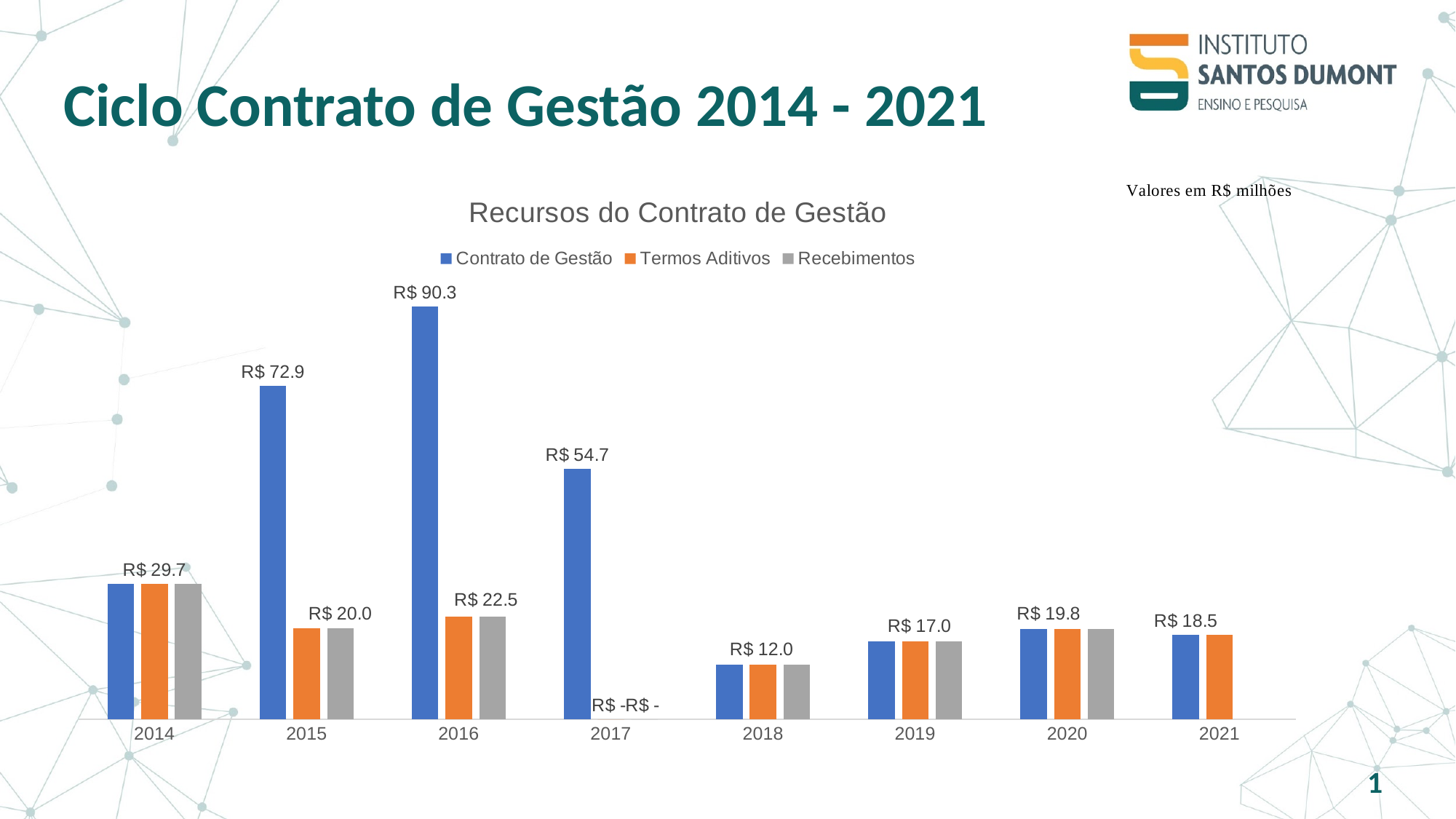
How many series does the legend list? 3 What kind of chart is shown? Bar chart What is the value of Contrato de Gestão in 2017? R$ 54.7 What is the difference between the Contrato de Gestão values in 2016 and 2015? R$ 17.4 What is the value of Contrato de Gestão in 2016? R$ 90.3 What is the value of Contrato de Gestão in 2015? R$ 72.9 Which is larger, the Contrato de Gestão value in 2015 or in 2017? 2015 What is the title of the chart? Recursos do Contrato de Gestão What is the value of Termos Aditivos in 2016? R$ 22.5 What is the value of Termos Aditivos in 2021? R$ 18.5 In which year is the Contrato de Gestão value highest? 2016 How many years are shown on the x axis? 8